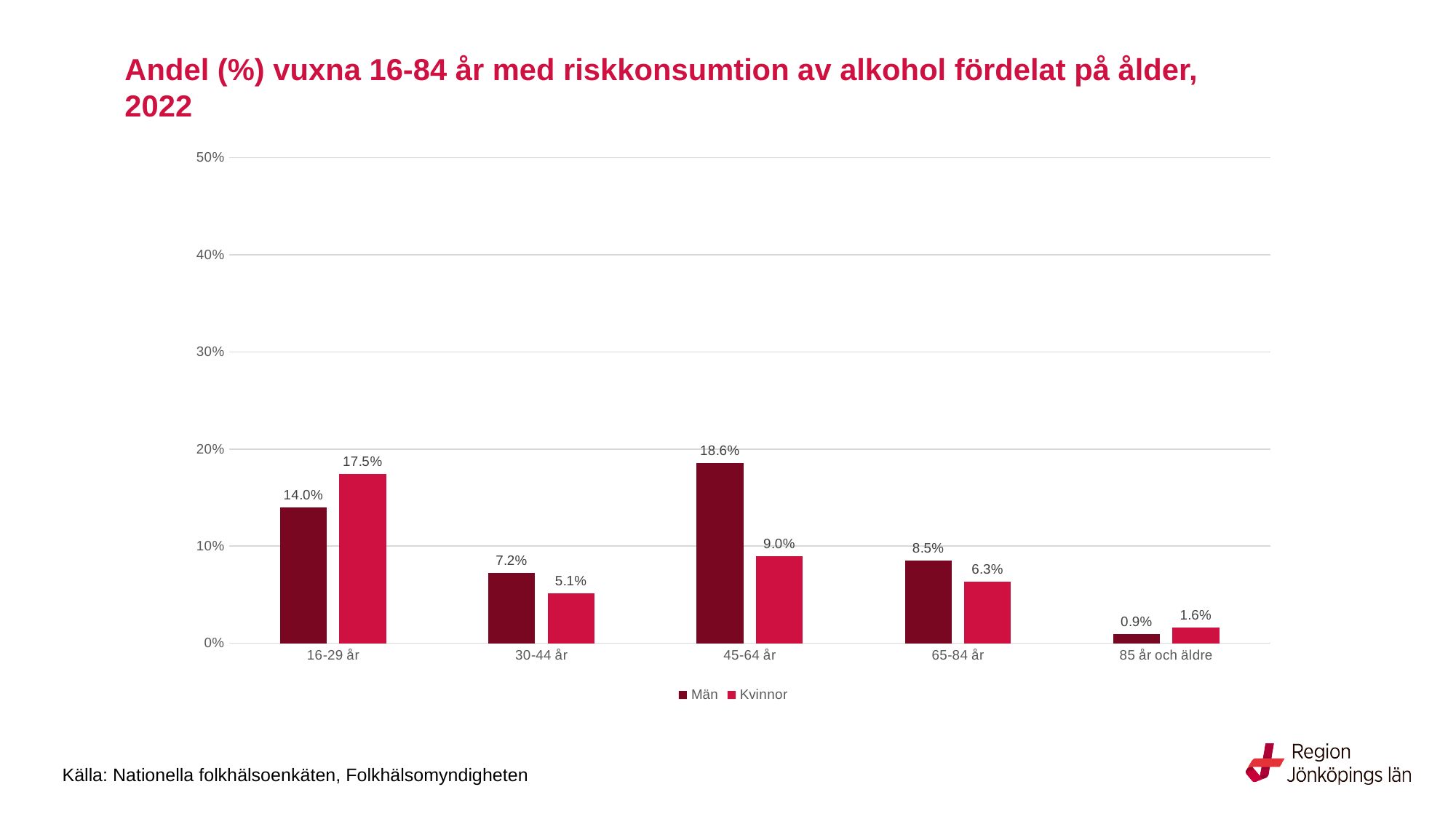
What is the value for Kvinnor in the 85 år och äldre age group? 1.6% How many age groups are shown on the x axis? 5 How many series does the legend list? 2 What is the difference between Män and Kvinnor in the 45-64 år age group? 9.6 percentage points What is the source given for the data on the slide? Nationella folkhälsoenkäten, Folkhälsomyndigheten Which is larger in the 16-29 år age group, Män or Kvinnor? Kvinnor Which age group has the lowest value for Kvinnor? 85 år och äldre What is the value for Kvinnor in the 16-29 år age group? 17.5% What kind of chart is shown on the slide? Bar chart Which age group has the highest value for Män? 45-64 år What is the value for Män in the 45-64 år age group? 18.6% Is the value for Män in the 65-84 år age group greater or less than 10%? less